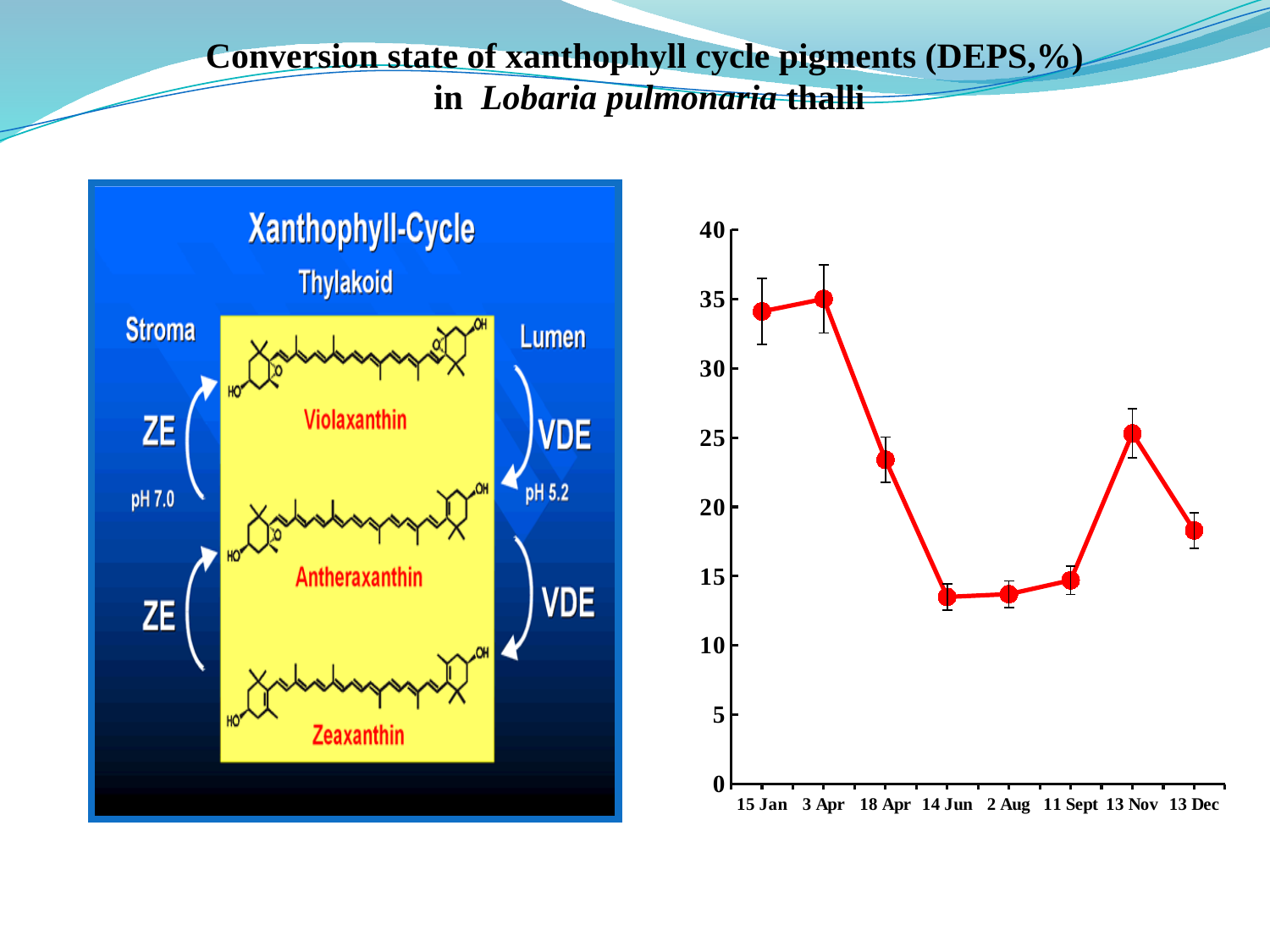
What is the highest value shown on the y axis of the line chart? 40 Is the value for 18 Apr greater or less than 20? greater What kind of chart is shown on the right side of the slide? line chart Is the value for 14 Jun greater or less than 15? less Which has the larger value, 15 Jan or 14 Jun? 15 Jan Do the values rise or fall from 3 Apr to 14 Jun? fall Which has the larger value, 13 Nov or 13 Dec? 13 Nov How many data points are plotted on the line chart? 8 Is the value for 11 Sept greater or less than 20? less